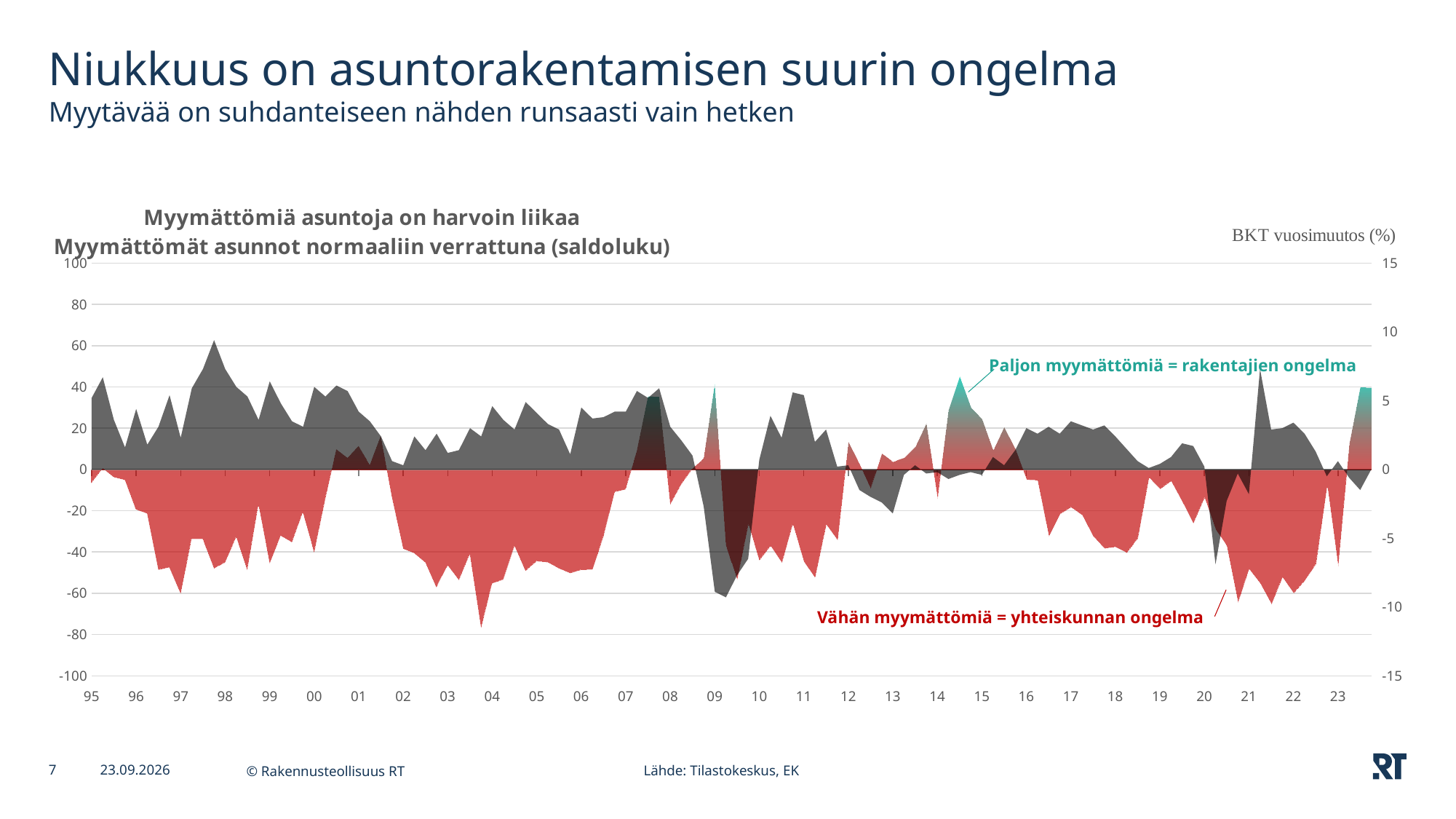
What is the label of the right-hand vertical axis? BKT vuosimuutos (%) Is the saldoluku peak around 14 greater or less than 20? greater How many year labels are shown on the x axis? 29 Is the lowest point of the saldoluku series around 04 greater or less than -60? less Is the saldoluku trough around 21 greater or less than -40? less What is the lowest value shown on the right vertical axis? -15 Is the saldoluku trough around 04 lower or higher than the saldoluku trough around 21? lower What is the title of the chart? Myymättömiä asuntoja on harvoin liikaa Myymättömät asunnot normaaliin verrattuna (saldoluku) What kind of chart is shown on the slide? area chart What is the highest value shown on the left vertical axis? 100